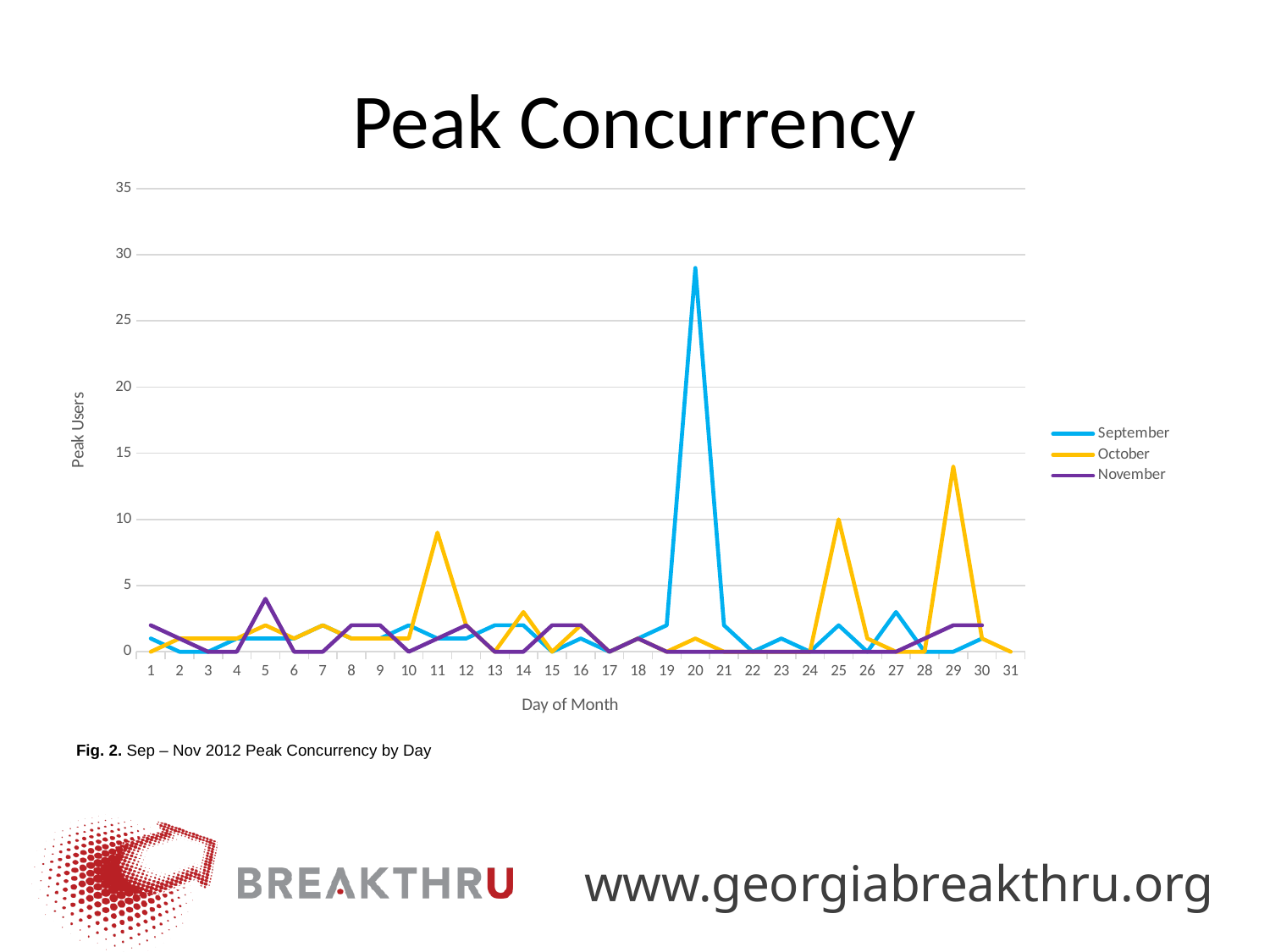
Is the November value on day 5 greater or less than 5? less What is the title of the chart? Peak Concurrency How many series does the legend list? 3 Which is larger: the September value on day 20 or the October value on day 29? September value on day 20 Which series reaches the highest peak value on the chart? September How many days are shown along the x axis? 31 Which series are listed in the legend? September, October, November Is the September value on day 20 greater or less than 25? greater What kind of chart is shown on the slide? line chart What is the November value on day 20? 0 Is the October value on day 11 greater or less than 5? greater